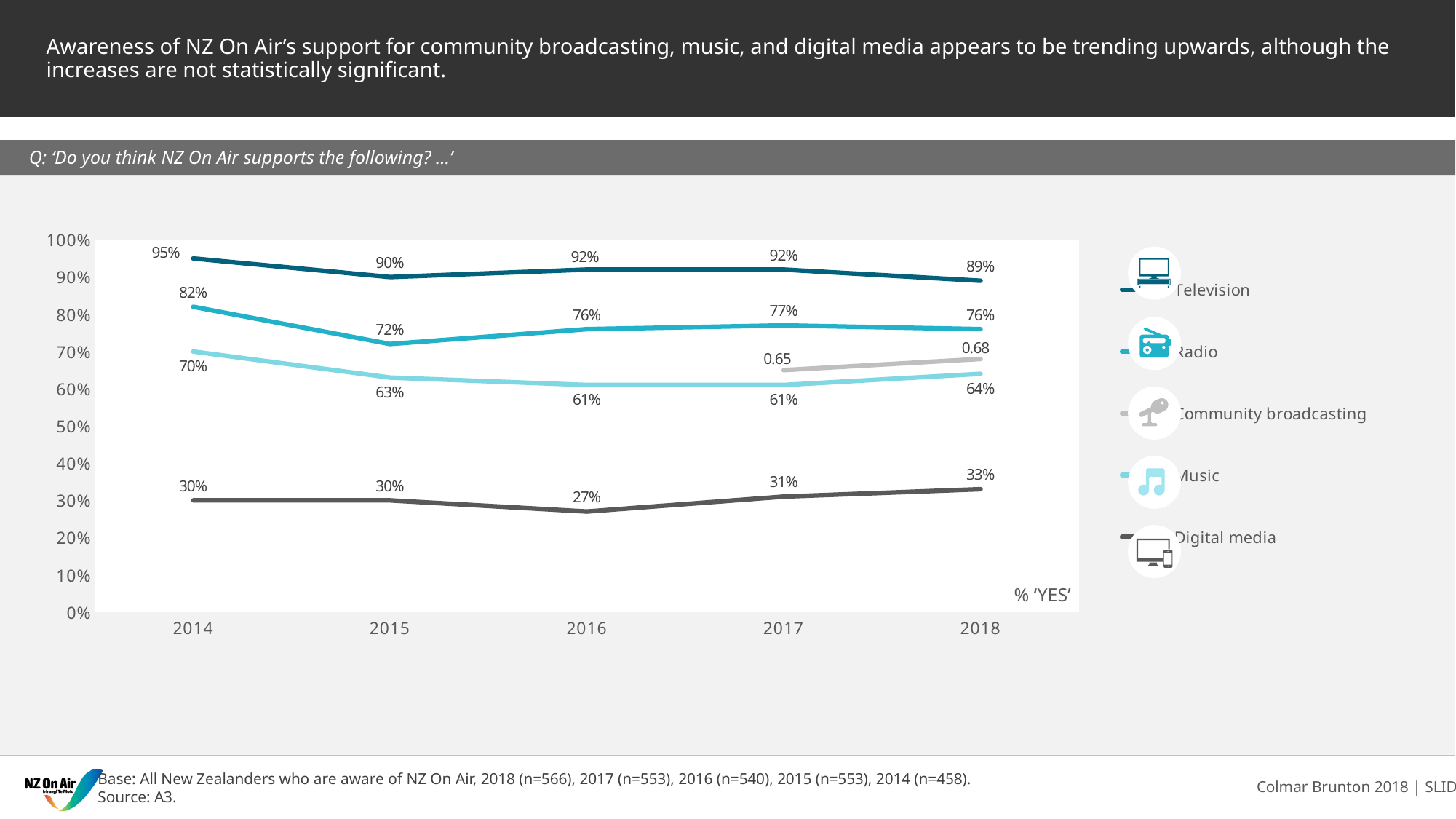
In which year was the Music value highest? 2014 In which year was the Television value lowest? 2018 How many series does the legend list? 5 What is the value for Radio in 2017? 77% What is the difference between the Radio value in 2014 and in 2015? 10% Which is larger in 2018: the Music value or the Digital media value? Music What type of chart is shown on the slide? Line chart What is the value for Community broadcasting in 2018? 0.68 What is the value for Television in 2014? 95% How many years are shown on the x axis? 5 What is the value for Digital media in 2016? 27% Does the Digital media value rise or fall from 2016 to 2018? Rise